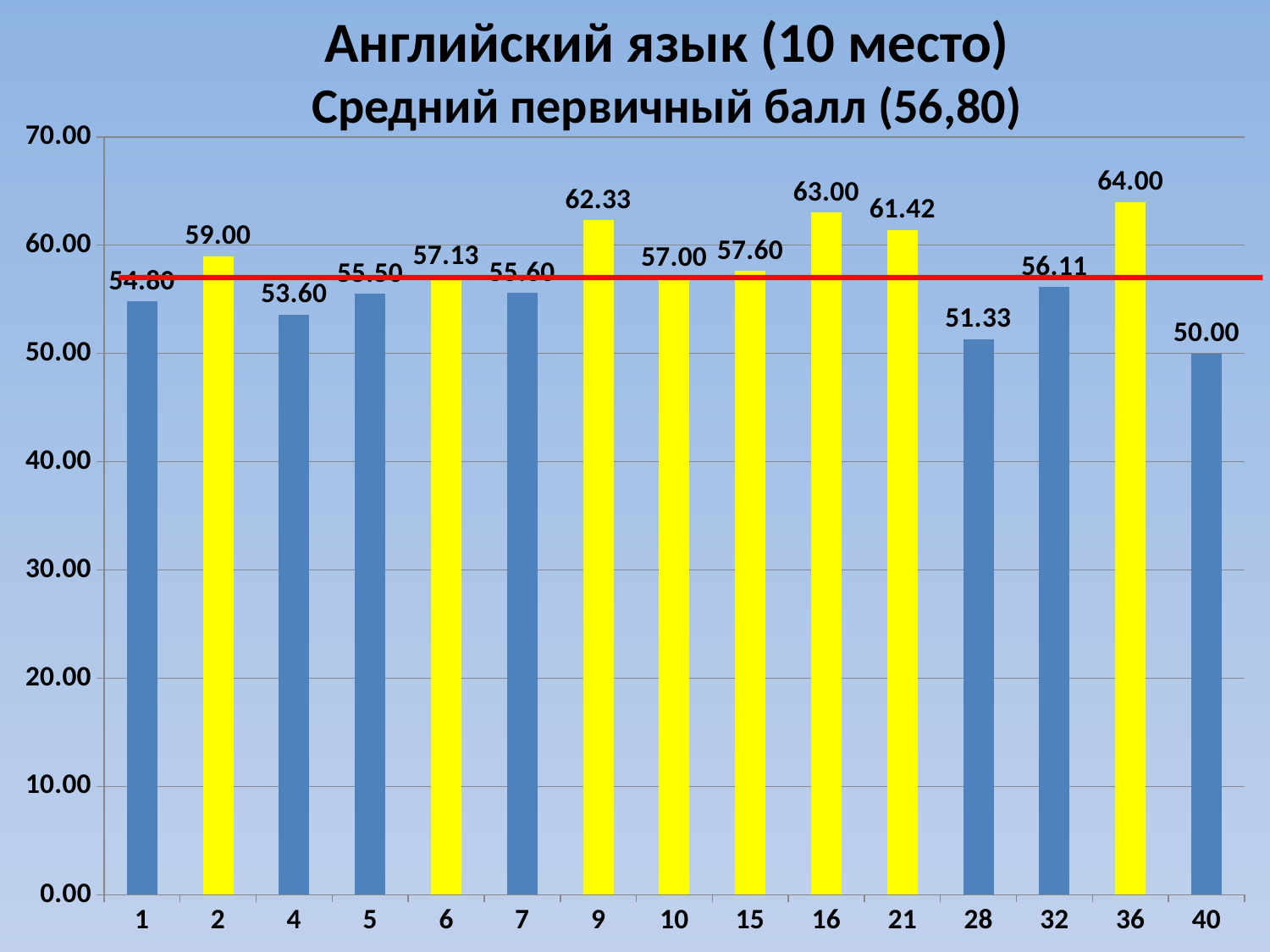
What is the difference between the values for category 36 and category 40? 14.00 What average score is given in the chart's subtitle? 56,80 Is the value for category 7 greater or less than 60.00? less Which is larger, the value for category 21 or the value for category 32? 21 What is the value for category 9? 62.33 Which category has the lowest value? 40 What is the value for category 28? 51.33 What kind of chart is shown on the slide? bar chart Which category has the highest value? 36 What is the difference between the values for category 2 and category 4? 5.40 How many categories are shown on the x axis? 15 What is the value for category 16? 63.00